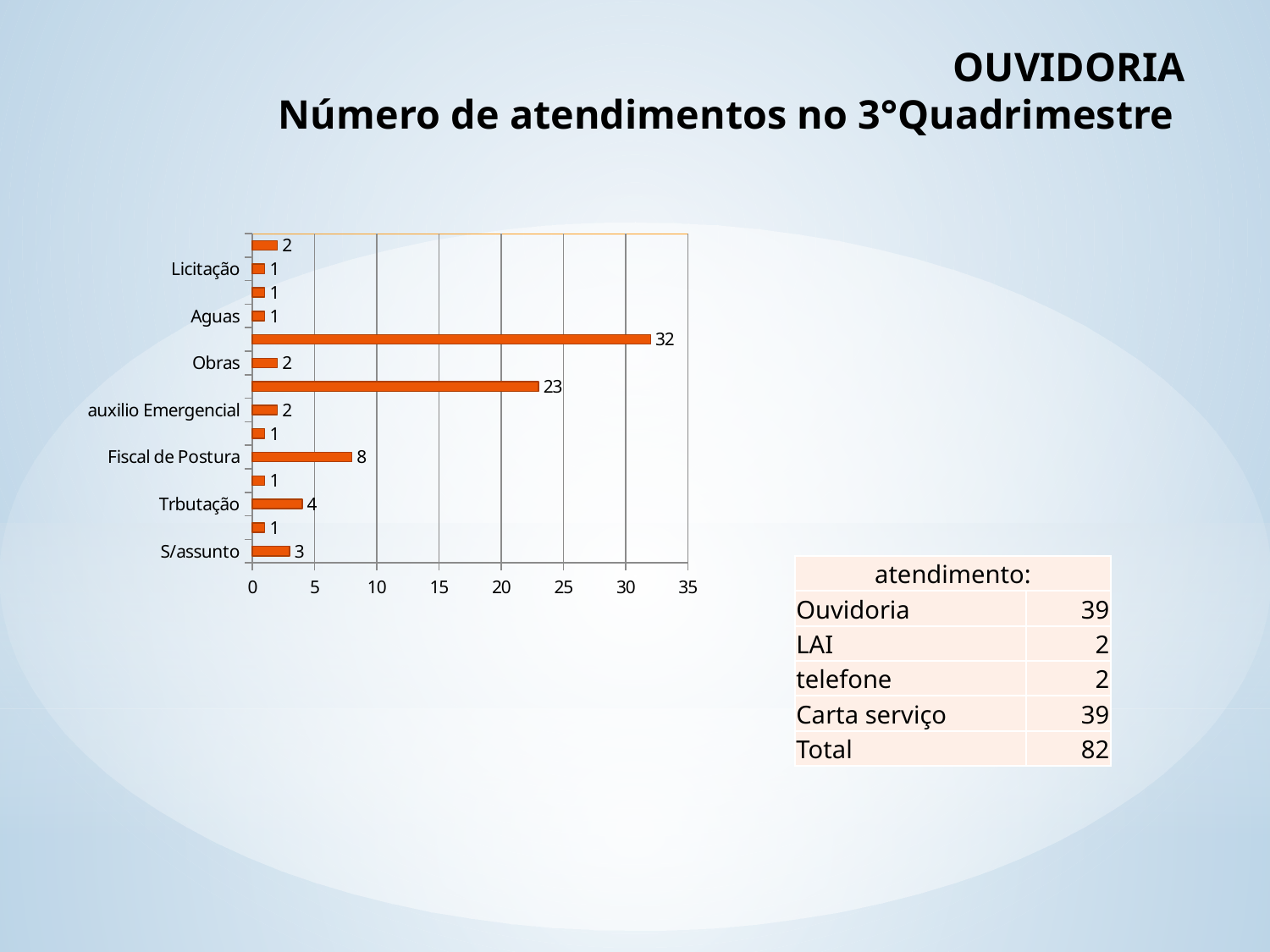
Is the value of the longest bar greater or less than 30? greater What is the value for Obras? 2 What is the value for Trbutação? 4 How many bars are plotted in the chart? 14 What kind of chart is shown on the slide? bar chart What is the highest value shown on the horizontal axis of the chart? 35 What is the value for Fiscal de Postura? 8 What is the largest value labeled on any bar in the chart? 32 What is the value for S/assunto? 3 What is the value for Licitação? 1 Which is larger, the value for Fiscal de Postura or the value for S/assunto? Fiscal de Postura What is the difference between the values for Fiscal de Postura and Trbutação? 4